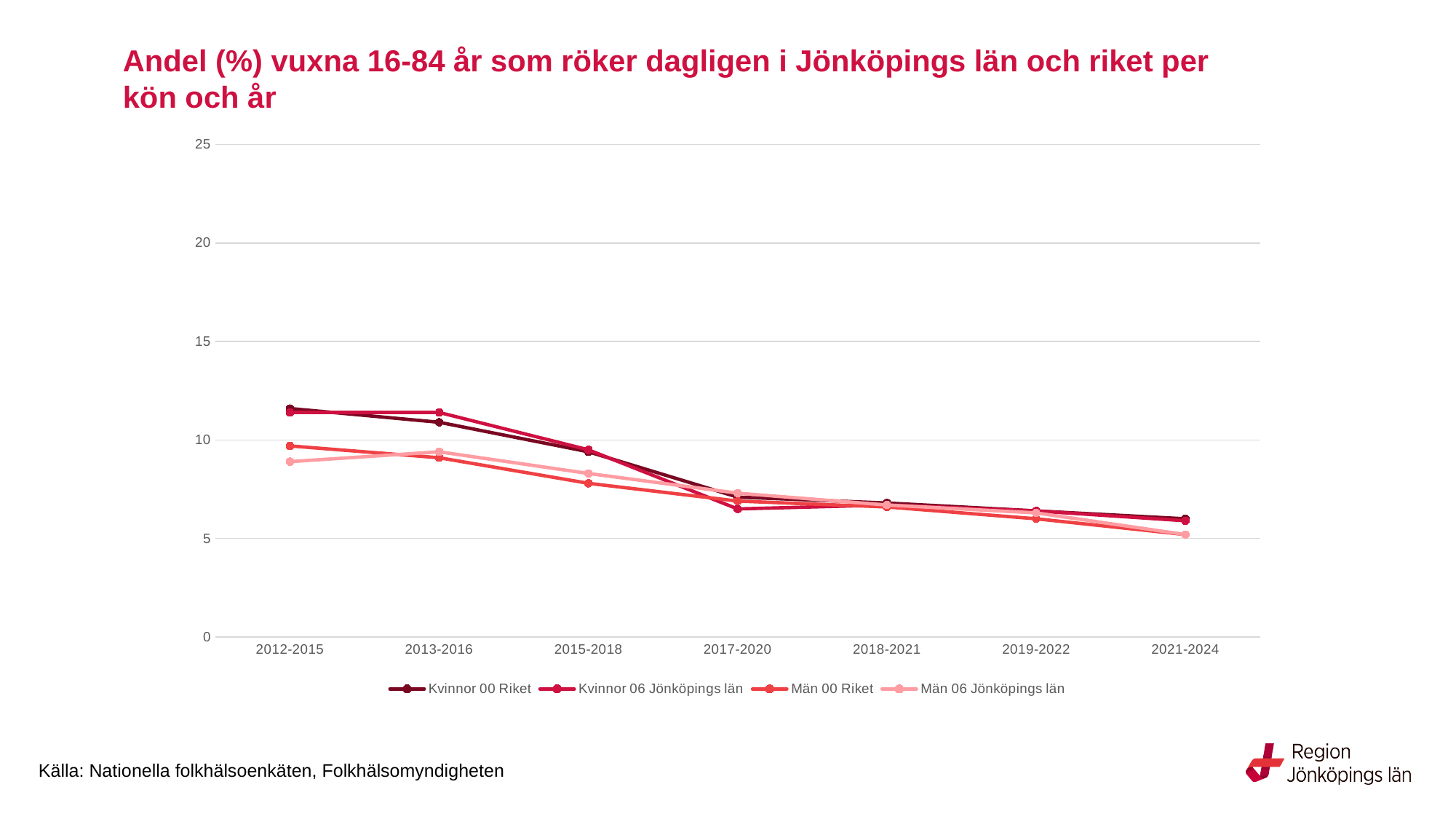
Which series has the lowest value in 2012-2015? Män 06 Jönköpings län What kind of chart is shown on the slide? line chart Which series is listed last in the legend? Män 06 Jönköpings län Is the value for Kvinnor 00 Riket in 2012-2015 greater or less than 10? greater In 2012-2015, which is larger: Kvinnor 00 Riket or Män 06 Jönköpings län? Kvinnor 00 Riket Is the value for Män 06 Jönköpings län in 2012-2015 greater or less than 10? less How many time periods are shown on the x axis? 7 Does the value for Män 00 Riket rise or fall from 2012-2015 to 2021-2024? fall Is the value for Män 00 Riket in 2015-2018 greater or less than 10? less How many series does the legend list? 4 What is the title of the chart? Andel (%) vuxna 16-84 år som röker dagligen i Jönköpings län och riket per kön och år Does the value for Kvinnor 00 Riket rise or fall from 2012-2015 to 2021-2024? fall